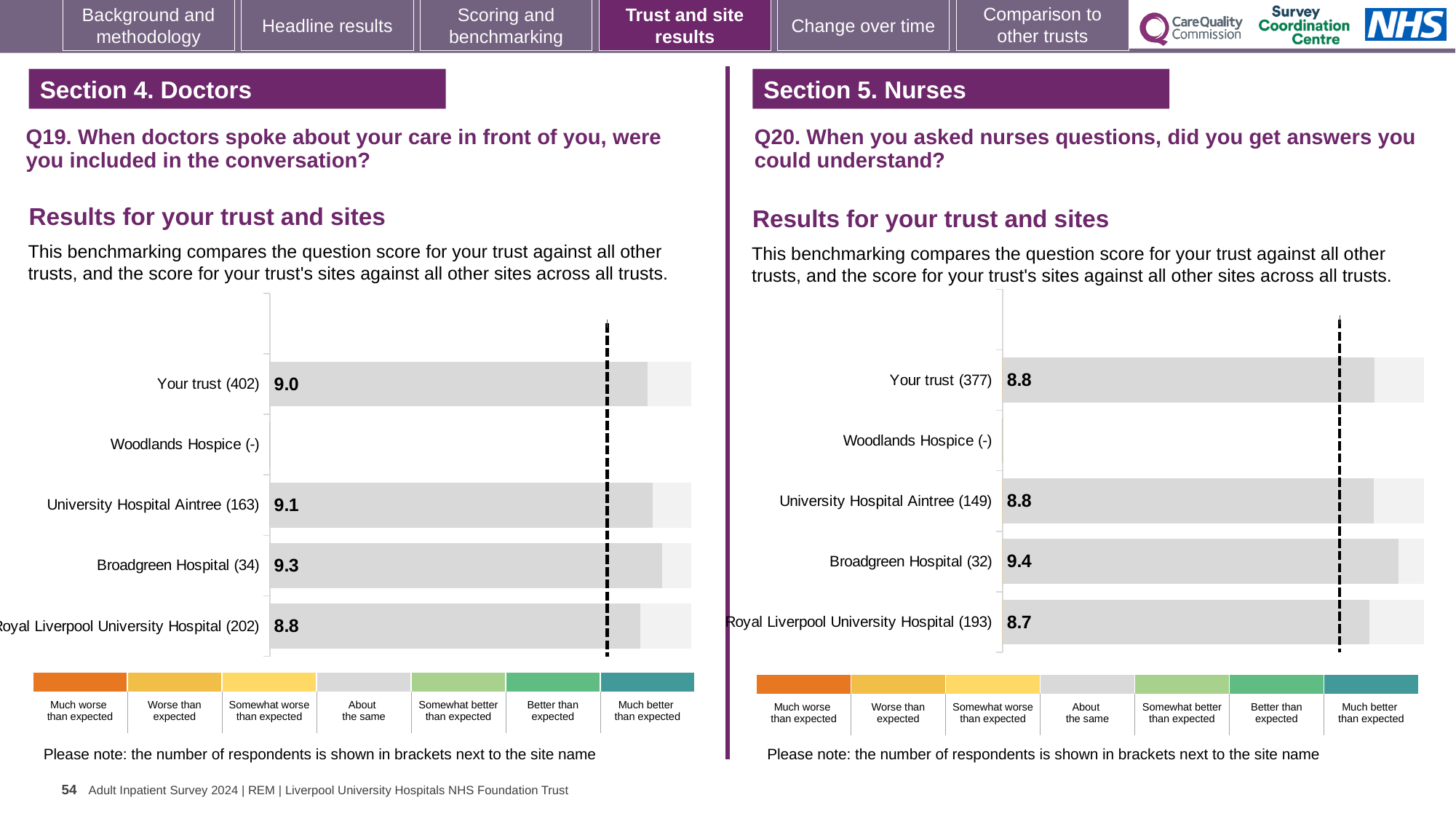
In the Q19 chart on the left, how many respondents are shown in brackets for Your trust? 402 In the Q20 chart on the right, what is the difference between the scores for Broadgreen Hospital and University Hospital Aintree? 0.6 In the Q20 chart on the right, which site or trust has the lowest score? Royal Liverpool University Hospital In the Q19 chart on the left, which site or trust has the highest score? Broadgreen Hospital In the Q19 chart on the left, what is the difference between the scores for Broadgreen Hospital and Royal Liverpool University Hospital? 0.5 In the Q19 chart on the left, what is the score for Broadgreen Hospital? 9.3 In the Q20 chart on the right, how many sites or trusts are listed on the vertical axis? 5 What kind of chart is used for the Q19 results on the left? Bar chart In the Q19 chart on the left, what is the score for Royal Liverpool University Hospital? 8.8 In the Q20 chart on the right, what is the score for Broadgreen Hospital? 9.4 In the Q20 chart on the right, what is the score for Your trust? 8.8 In the Q19 chart on the left, which has the higher score: Your trust or University Hospital Aintree? University Hospital Aintree